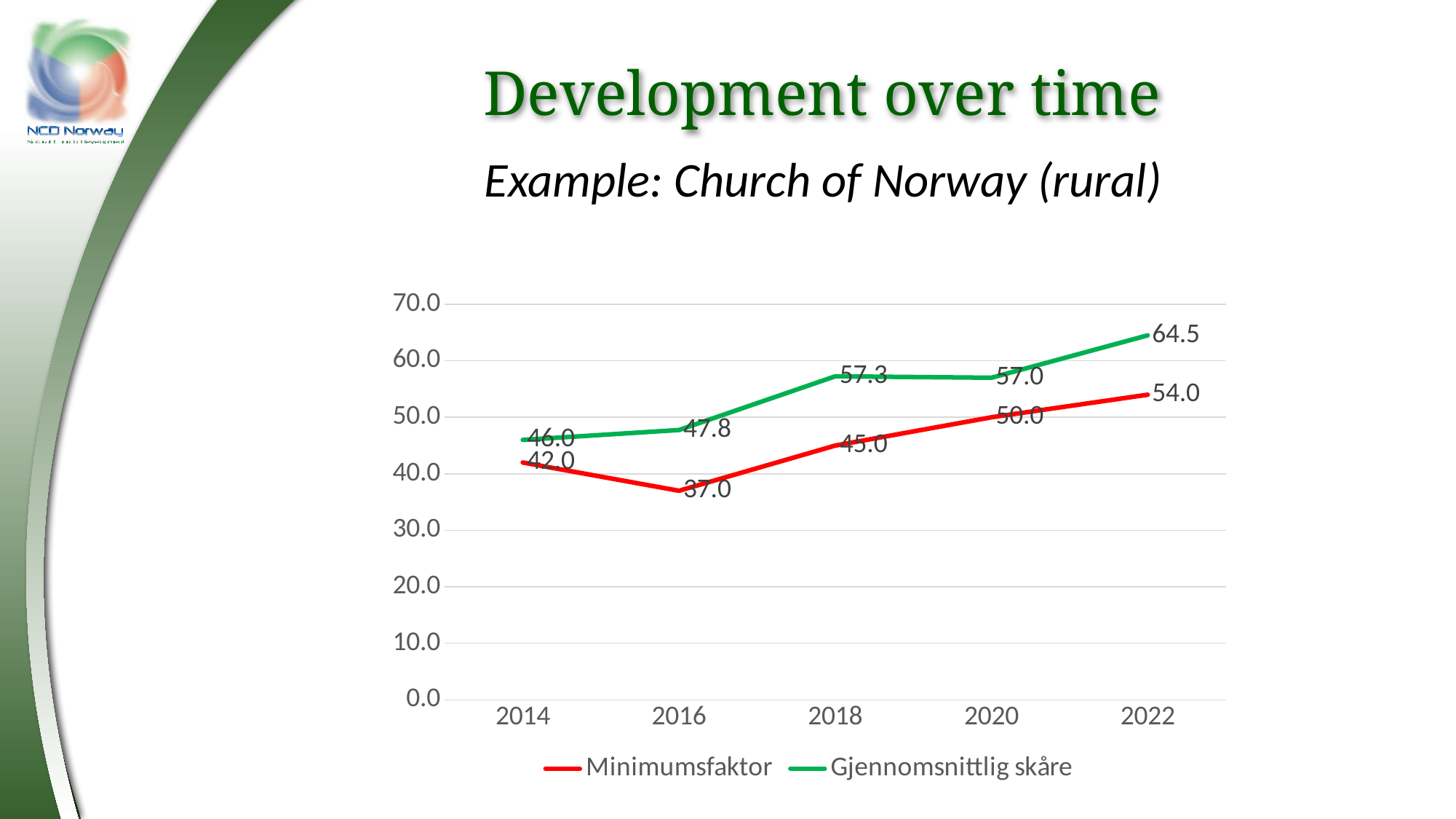
What is the difference between Gjennomsnittlig skåre and Minimumsfaktor in 2022? 10.5 How many years are plotted on the x axis? 5 How many series does the legend list? 2 What is the Minimumsfaktor value for 2016? 37.0 What is the Minimumsfaktor value for 2020? 50.0 Which is larger in 2014, Minimumsfaktor or Gjennomsnittlig skåre? Gjennomsnittlig skåre What is the Gjennomsnittlig skåre value for 2022? 64.5 What kind of chart is shown on the slide? Line chart What is the Gjennomsnittlig skåre value for 2018? 57.3 In which year is the Minimumsfaktor lowest? 2016 In which year is the Gjennomsnittlig skåre highest? 2022 Does the Minimumsfaktor rise or fall from 2016 to 2022? Rise